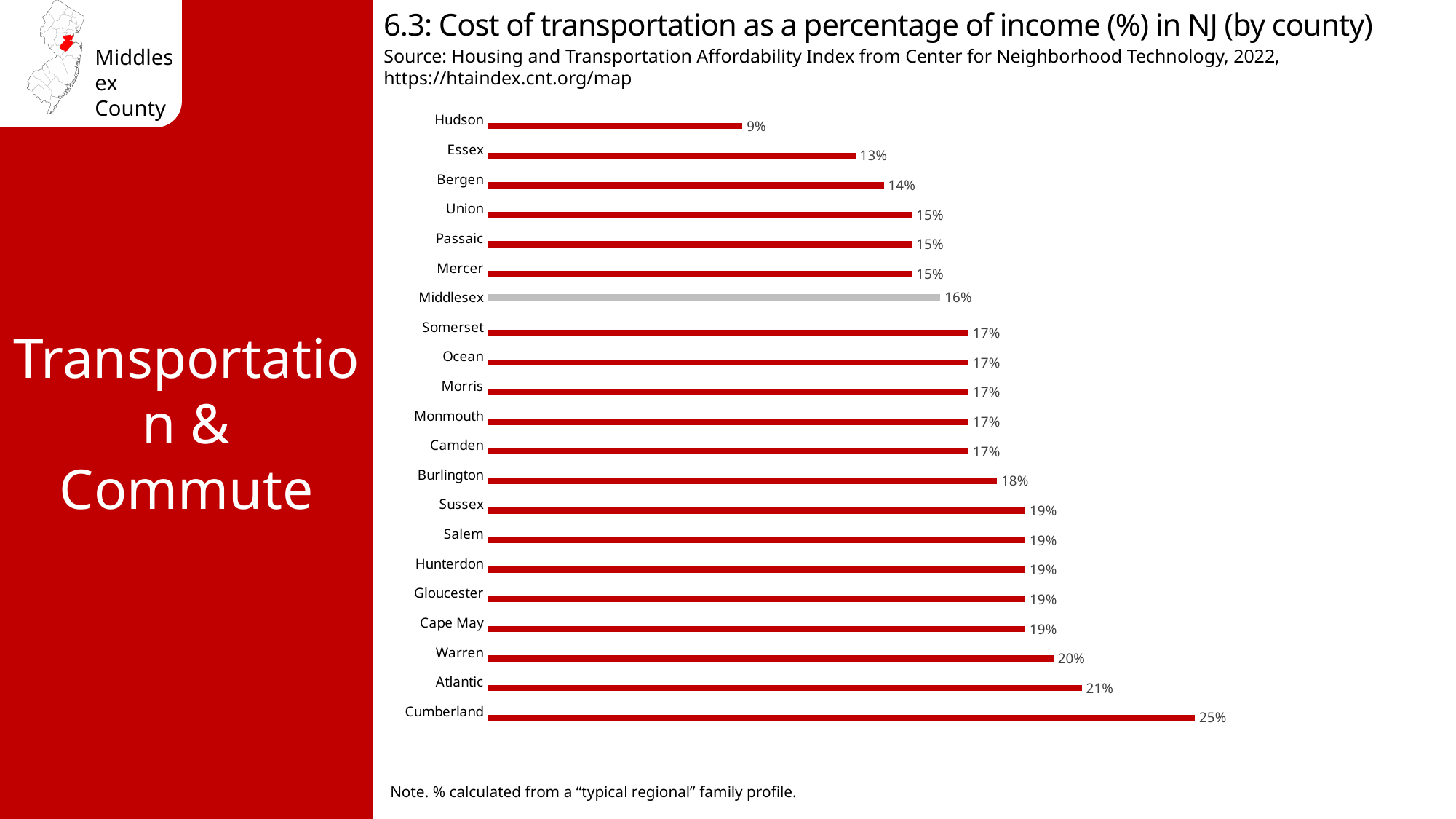
Which county has the lowest cost of transportation as a percentage of income? Hudson How many counties are shown in the chart? 21 What is the difference between the values for Cumberland and Hudson? 16% What is the cost of transportation as a percentage of income for Cumberland County? 25% What is the value shown for Burlington County? 18% What is the difference between the values for Atlantic and Middlesex? 5% What type of chart is shown on the slide? Bar chart What is the cost of transportation as a percentage of income for Middlesex County? 16% Which has a higher value, Warren or Bergen? Warren Which county has the highest cost of transportation as a percentage of income? Cumberland What is the value shown for Hudson County? 9% Which county's bar is shown in grey rather than red? Middlesex